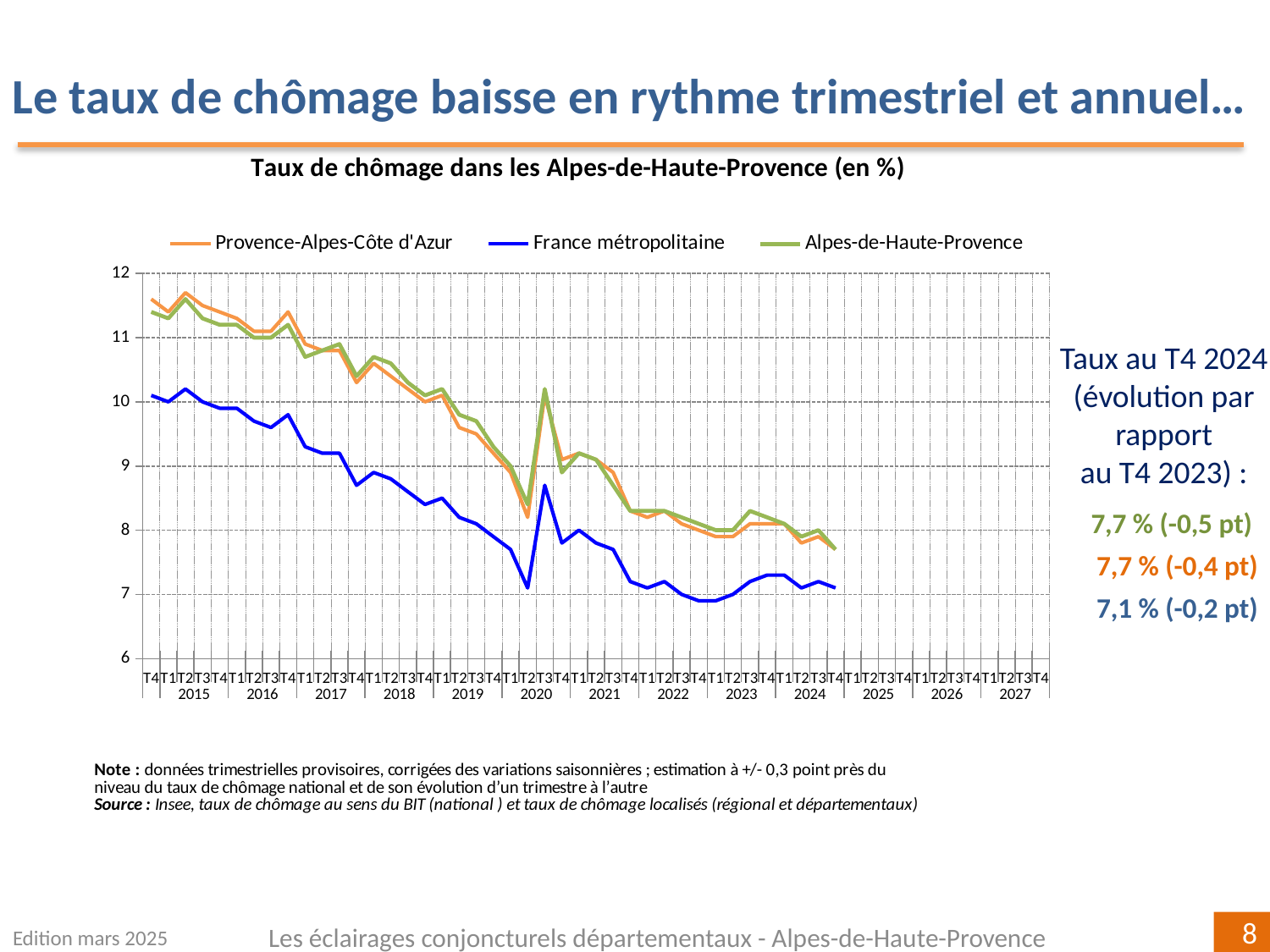
What colour is the line for France métropolitaine? blue At T4 2024, which is higher: the rate for Alpes-de-Haute-Provence or for France métropolitaine? Alpes-de-Haute-Provence Is the value for Alpes-de-Haute-Provence at T4 2014 greater or less than 11? greater What is the unemployment rate for France métropolitaine at T4 2024? 7,1 % What is the unemployment rate for Alpes-de-Haute-Provence at T4 2024? 7,7 % What is the unemployment rate for Provence-Alpes-Côte d'Azur at T4 2024? 7,7 % What kind of chart is shown on the slide? line chart How many series does the chart legend list? 3 What is the difference in points between the Alpes-de-Haute-Provence rate and the France métropolitaine rate at T4 2024? 0,6 Which series has the lowest values across the whole period? France métropolitaine Overall, do the unemployment rates rise or fall from 2014 to 2024? fall Is the value for France métropolitaine at its 2020 peak greater or less than 8? greater